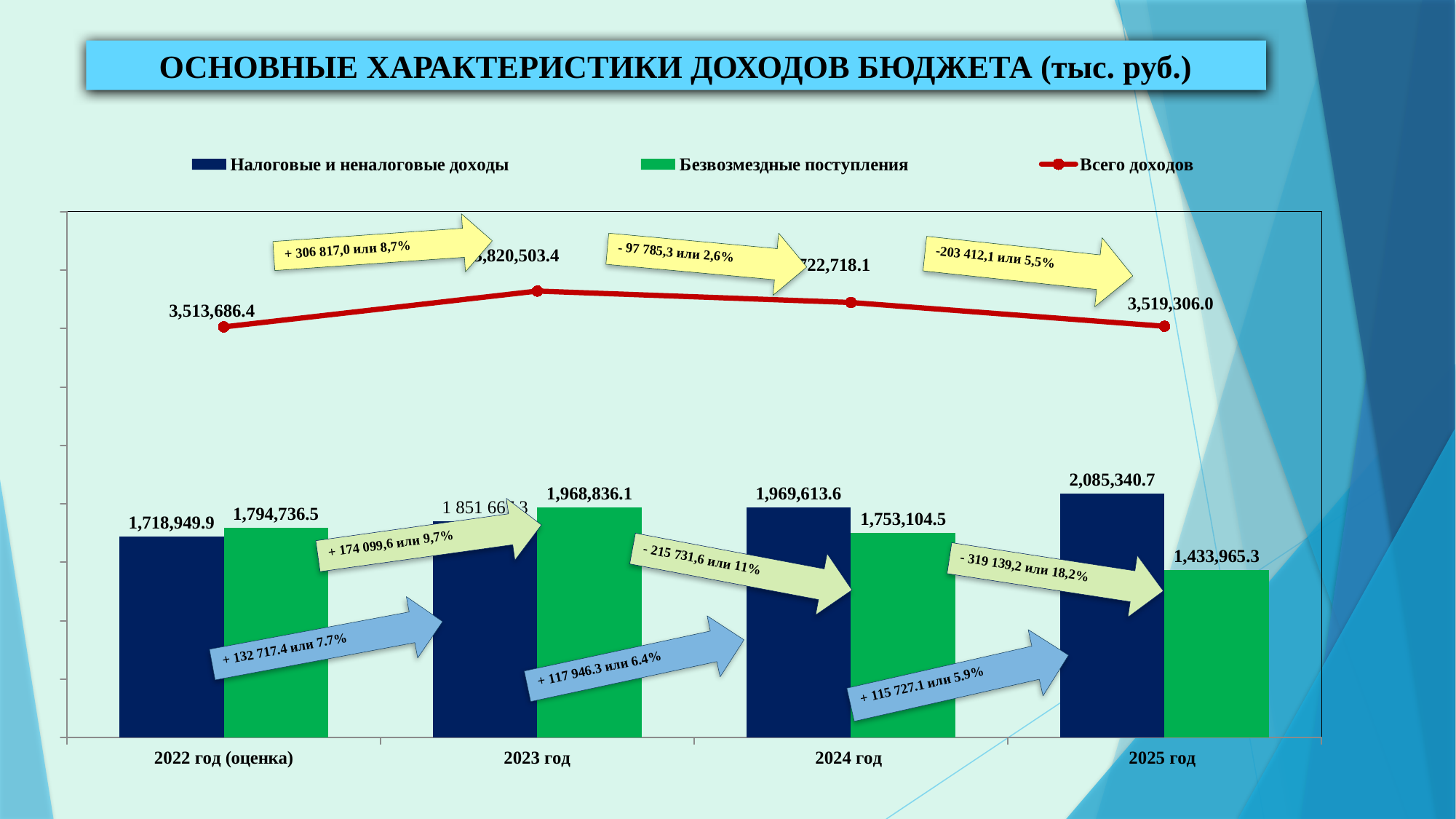
What is the value of Безвозмездные поступления for 2025 год? 1,433,965.3 What is the difference between Налоговые и неналоговые доходы and Безвозмездные поступления in 2025 год? 651,375.4 What is the value of Всего доходов for 2022 год (оценка)? 3,513,686.4 How many series does the legend list? 3 In 2024 год, which is larger: Налоговые и неналоговые доходы or Безвозмездные поступления? Налоговые и неналоговые доходы How many years are shown on the x axis? 4 Which year has the highest value of Налоговые и неналоговые доходы? 2025 год Which year has the lowest value of Безвозмездные поступления? 2025 год What is the value of Налоговые и неналоговые доходы for 2022 год (оценка)? 1,718,949.9 Does the value of Налоговые и неналоговые доходы rise or fall from 2022 to 2025? rises Which year has the highest value of Безвозмездные поступления? 2023 год What is the value of Всего доходов for 2025 год? 3,519,306.0